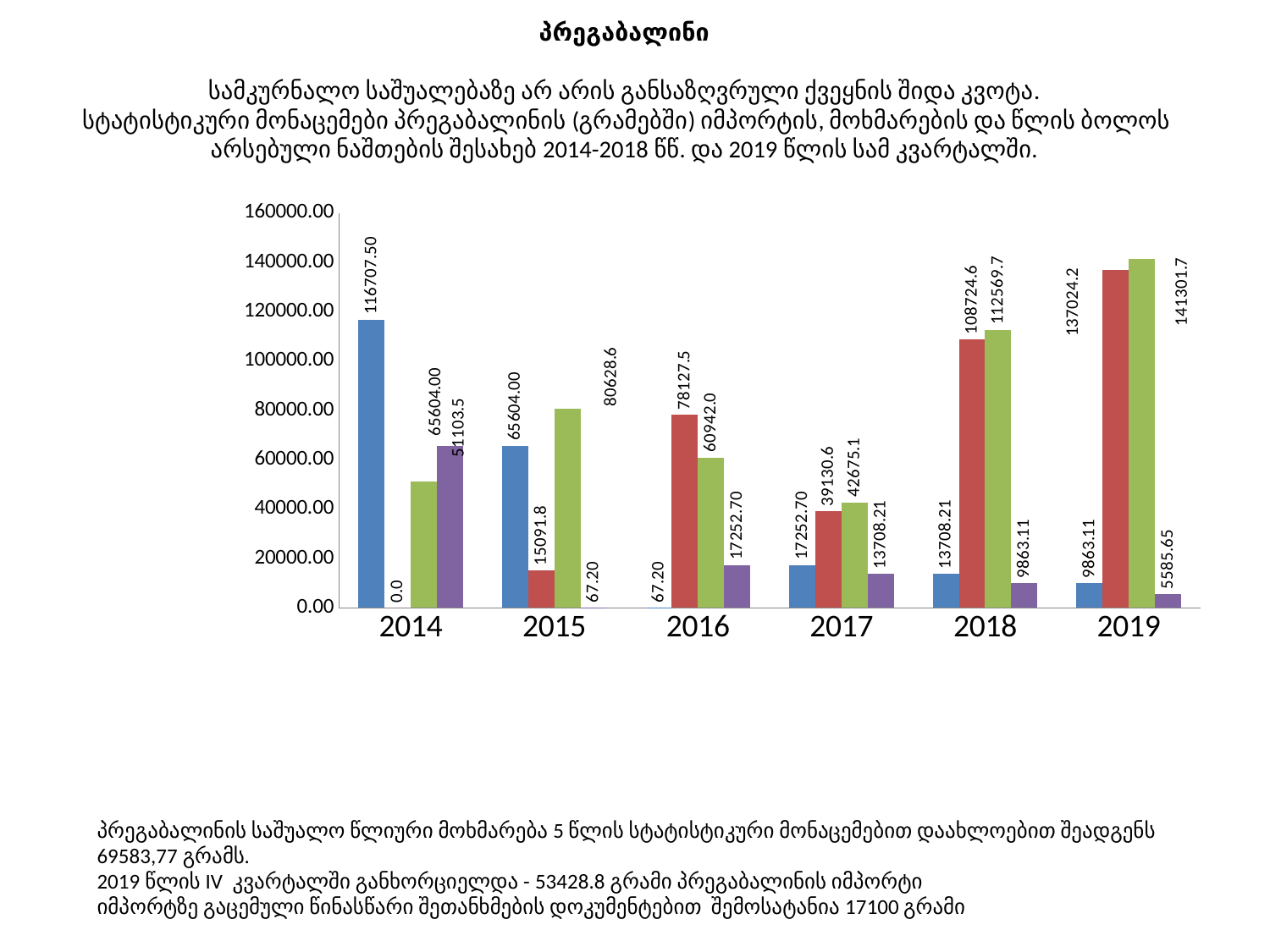
What is the value of the red bar for 2014? 0.0 Do the purple bars rise or fall from 2016 to 2019? fall In which year is the blue bar the lowest? 2016 In which year is the green bar the highest? 2019 How many years are shown on the x axis of the chart? 6 What is the value of the blue bar for 2014? 116707.50 What is the value of the purple bar for 2019? 5585.65 What kind of chart is shown on the slide? bar chart What is the difference between the green bar and the red bar in 2019? 4277.5 What is the value of the red bar for 2018? 108724.6 What is the value of the green bar for 2019? 141301.7 In 2016, which is larger: the red bar or the green bar? the red bar